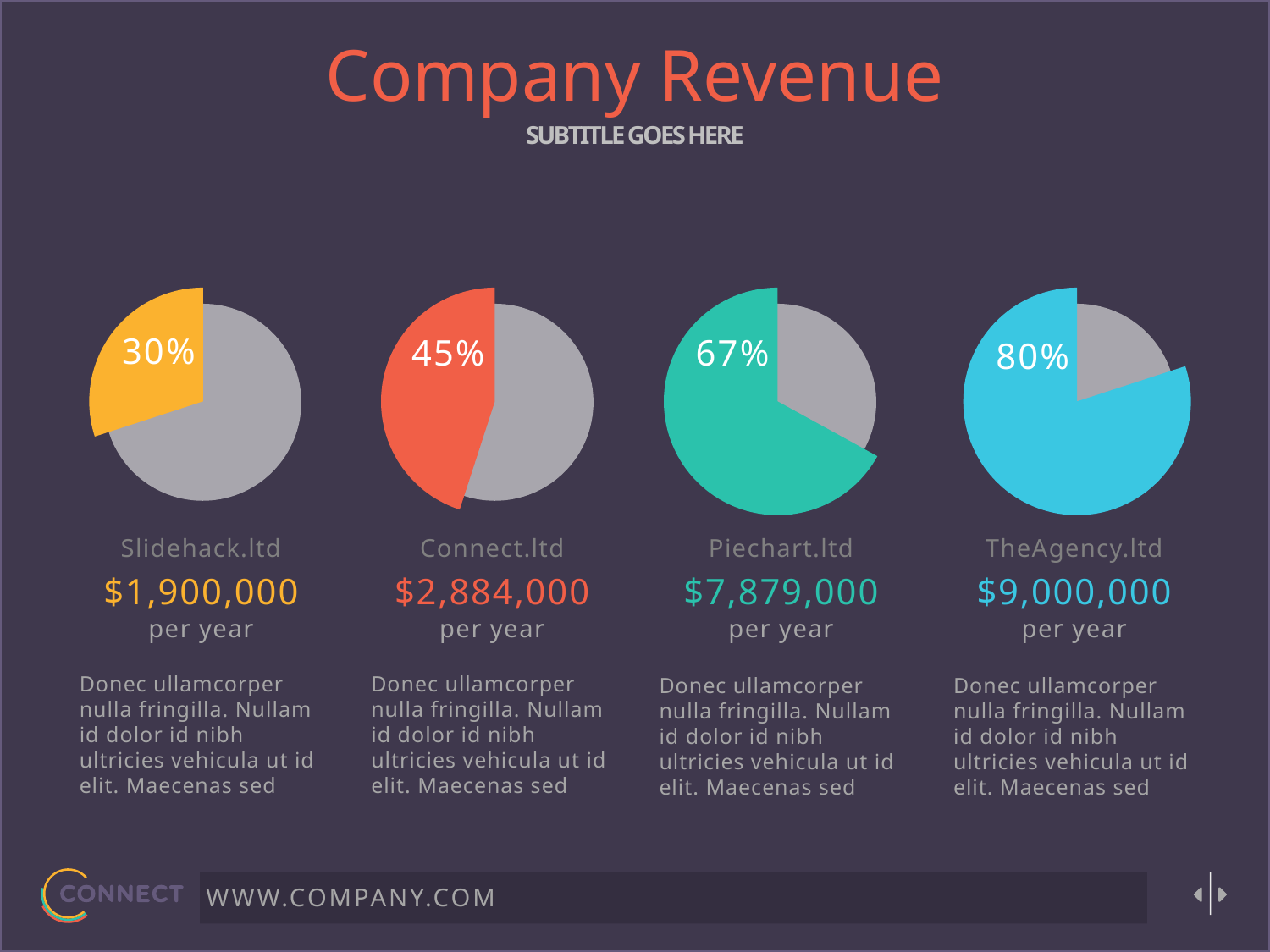
Which company's pie chart shows the lowest percentage? Slidehack.ltd Which pie chart shows a larger percentage, Connect.ltd or Piechart.ltd? Piechart.ltd In the Connect.ltd pie chart, what percentage does the highlighted slice show? 45% In the Slidehack.ltd pie chart, what percentage does the highlighted slice show? 30% What kind of chart is used for each company on the slide? Pie chart What is the difference in percentage points between the TheAgency.ltd pie chart and the Slidehack.ltd pie chart? 50 What revenue per year is shown under the Piechart.ltd pie chart? $7,879,000 What colour is the highlighted slice in the Slidehack.ltd pie chart? Yellow/orange In the Piechart.ltd pie chart, what percentage does the highlighted slice show? 67% Which company's pie chart shows the highest percentage? TheAgency.ltd How many pie charts are shown on the slide? 4